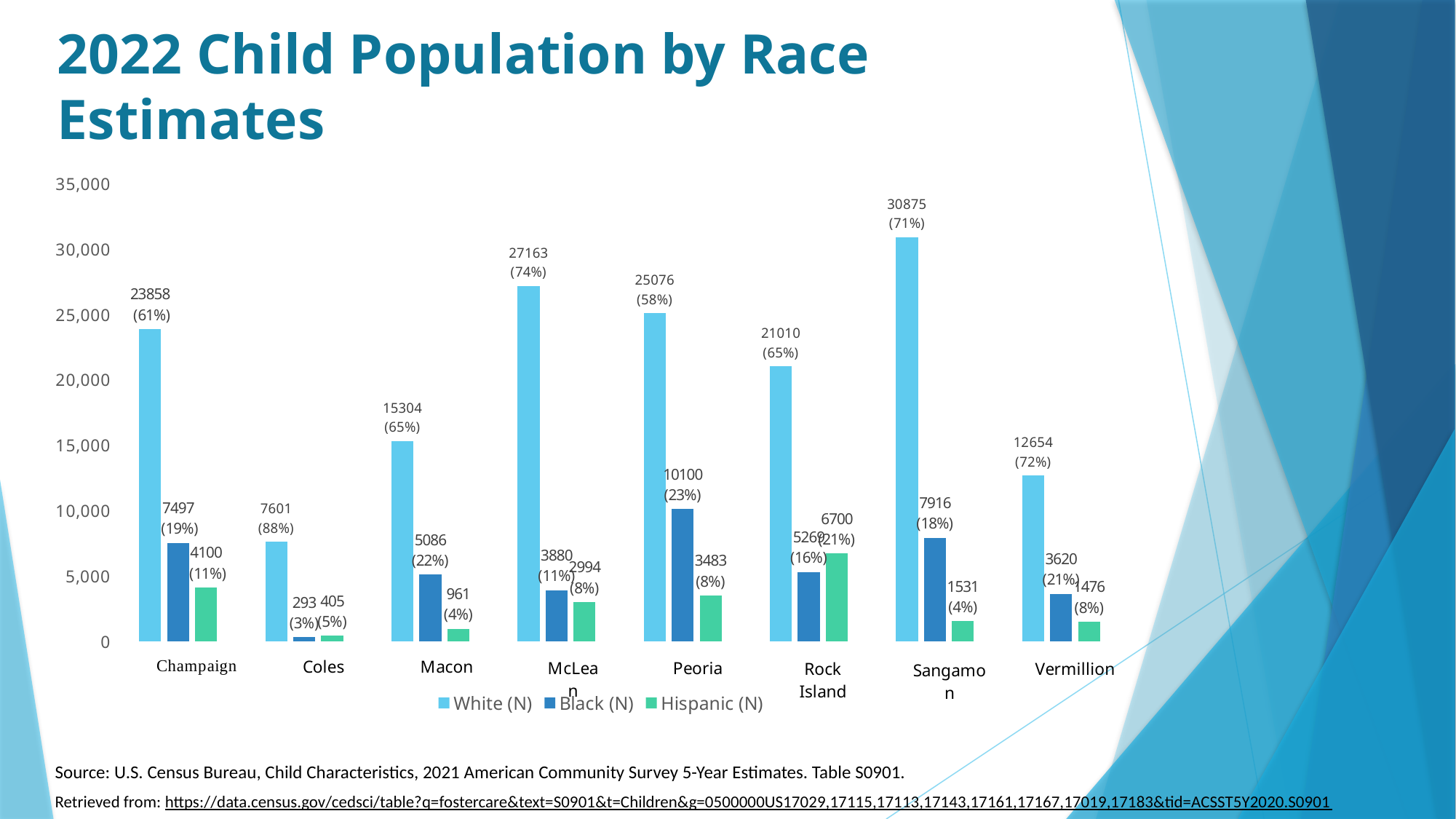
Which county has the lowest Black (N) value? Coles Which county has the highest White (N) value? Sangamon What kind of chart is shown on the slide? bar chart Which is larger, the Hispanic (N) value for Rock Island or for Champaign? Rock Island What is the total of the three values shown for Coles? 8299 How many counties are shown on the x axis? 8 What percentage is shown next to the White (N) bar for Coles? 88% What is the Black (N) value for Peoria? 10100 What is the difference between the White (N) values for Sangamon and McLean? 3712 How many series does the legend list? 3 What is the White (N) value for Champaign? 23858 Is the White (N) value for Vermillion greater or less than 10,000? greater